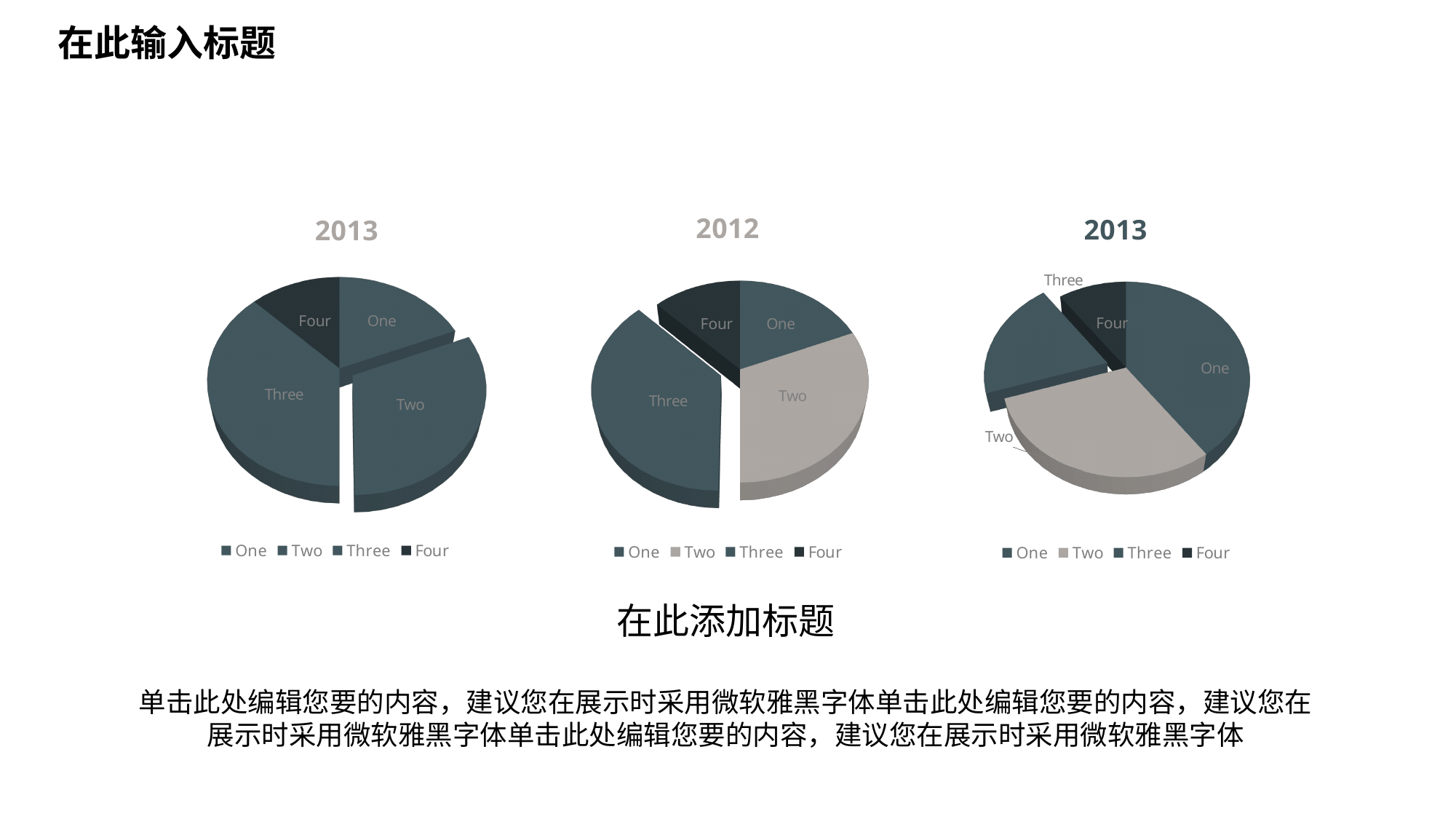
What kind of chart is the left-hand chart titled 2013? Pie chart In the middle chart titled 2012, which slice is the smallest? Four How many slices does the left-hand chart titled 2013 have? 4 How many pie charts are shown on the slide? 3 In the right-hand chart titled 2013, which slice is larger, One or Four? One In the right-hand chart titled 2013, which slice is larger, Two or Three? Two In the middle chart titled 2012, which slice is larger, Two or Four? Two How many slices does the middle chart titled 2012 have? 4 What is the title of the middle chart? 2012 In the right-hand chart titled 2013, which slice is the smallest? Four How many entries does the legend of the right-hand chart titled 2013 list? 4